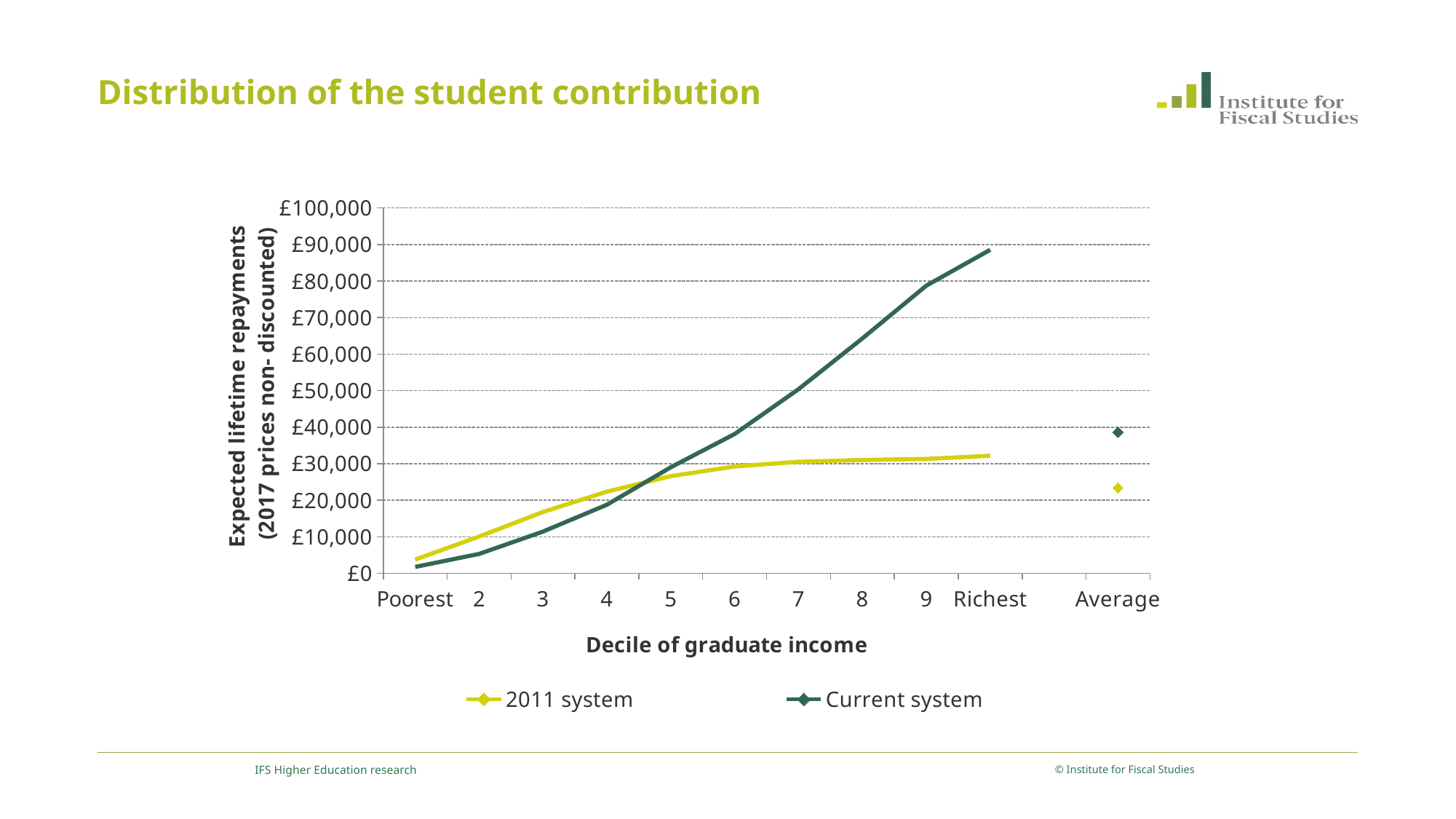
Is the 2011 system value for the Richest decile greater or less than £40,000? less What are the two series named in the legend? 2011 system and Current system Is the Current system value for the Richest decile greater or less than £80,000? greater Is the Current system value for Average greater or less than £30,000? greater Do the Current system expected lifetime repayments rise or fall from the Poorest decile to the Richest decile? rise For the Current system, which decile of graduate income has the lowest expected lifetime repayments? Poorest At the Richest decile, which series has the higher expected lifetime repayments, 2011 system or Current system? Current system How many series does the legend list? 2 For the Current system, which decile of graduate income has the highest expected lifetime repayments? Richest What is the title of the x axis? Decile of graduate income At the Poorest decile, which series has the higher expected lifetime repayments, 2011 system or Current system? 2011 system What kind of chart is shown on the slide? line chart